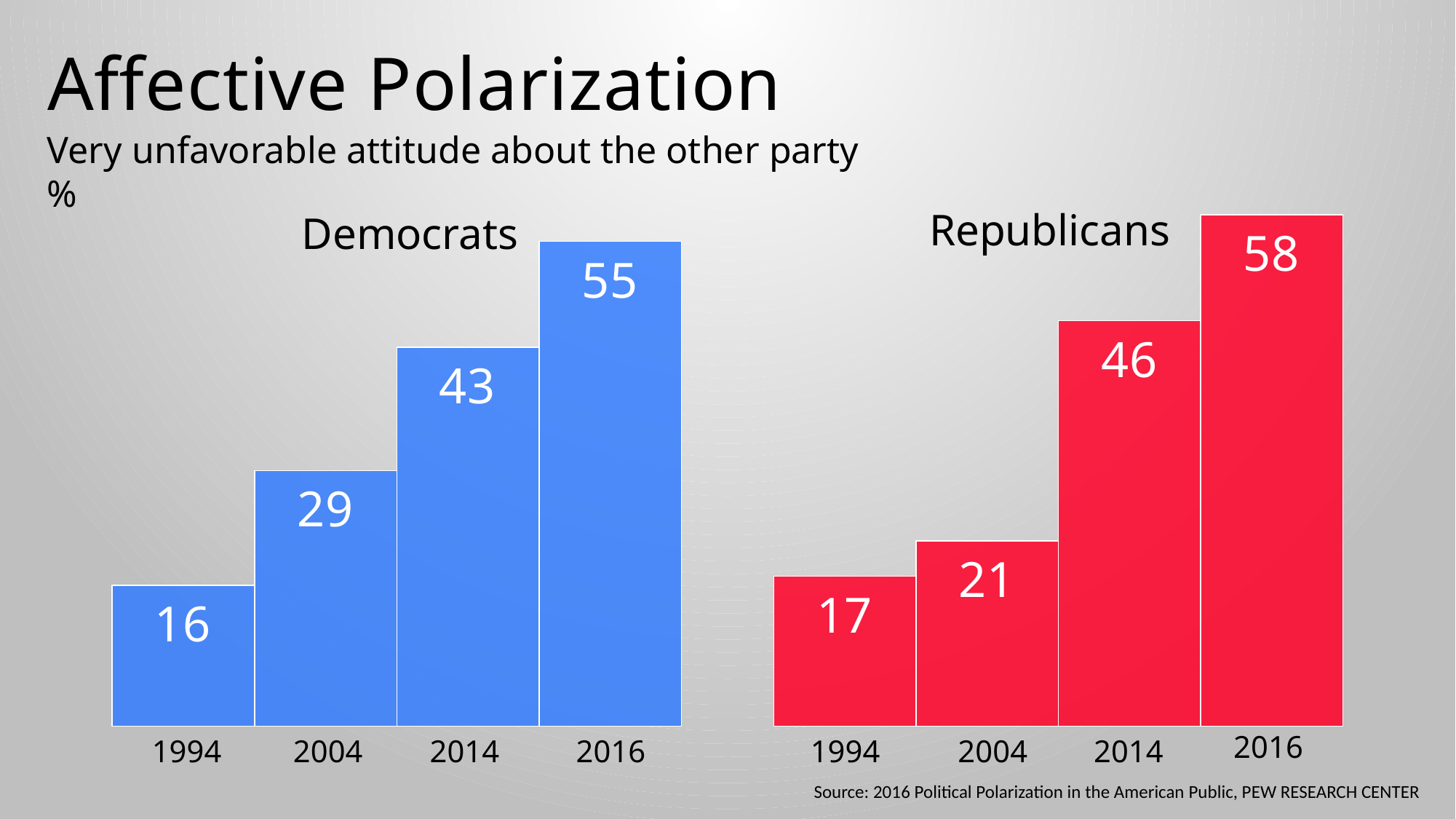
In the Republicans chart, what is the difference between the 2016 and 1994 values? 41 How many years are shown in the Republicans chart? 4 What kind of chart is the Democrats chart? Bar chart What colour are the bars in the Republicans chart? Red In the Democrats chart, which year has the lowest value? 1994 In the Democrats chart, what is the difference between the 2016 and 2014 values? 12 In the Democrats chart, what is the value for 1994? 16 In the Republicans chart, what is the value for 2014? 46 Which is larger: the 2016 value in the Democrats chart or the 2016 value in the Republicans chart? Republicans In the Republicans chart, do the values rise or fall from 1994 to 2016? Rise In the Democrats chart, what is the value for 2004? 29 In the Republicans chart, which year has the highest value? 2016